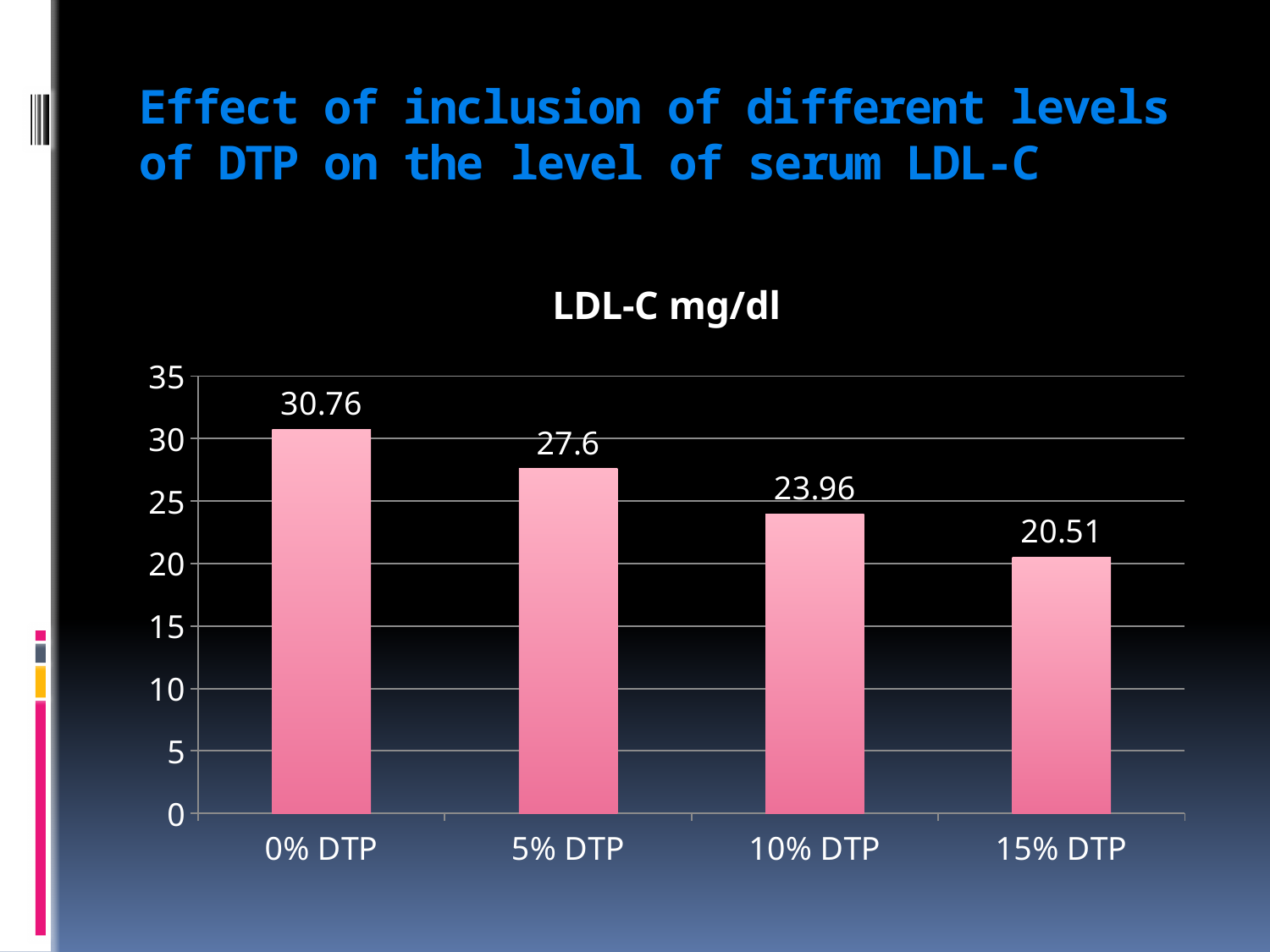
What is the LDL-C value for 15% DTP? 20.51 What is the title of the chart? LDL-C mg/dl How many DTP levels are shown on the chart? 4 What is the difference in LDL-C between 0% DTP and 15% DTP? 10.25 What is the LDL-C value for 10% DTP? 23.96 What is the LDL-C value for 5% DTP? 27.6 Do the LDL-C values rise or fall as the DTP level increases? Fall Which DTP level has the highest LDL-C value? 0% DTP What type of chart is shown on the slide? Bar chart Which has a higher LDL-C value, 5% DTP or 10% DTP? 5% DTP Which DTP level has the lowest LDL-C value? 15% DTP What is the LDL-C value for 0% DTP? 30.76